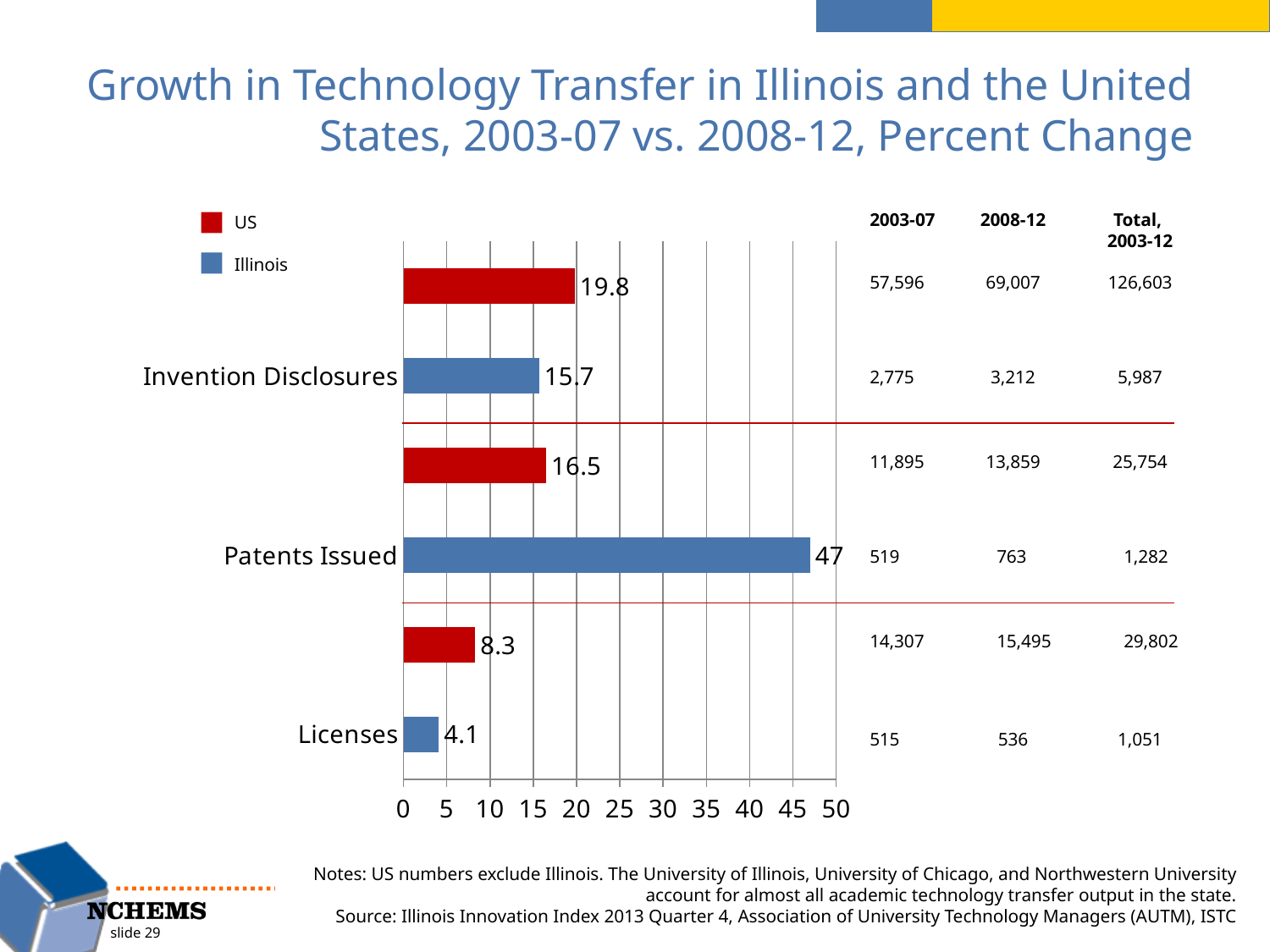
For Invention Disclosures, which is larger: the US or Illinois percent change? US Which category has the lowest percent change for the US? Licenses What is the percent change for Illinois in Licenses? 4.1 Which category has the highest percent change for Illinois? Patents Issued What is the percent change for the US in Invention Disclosures? 19.8 What kind of chart is shown on the slide? Bar chart What is the percent change for Illinois in Patents Issued? 47 How many categories are shown on the chart? 3 Is the Illinois value for Patents Issued greater or less than 45? greater What is the percent change for the US in Licenses? 8.3 What is the difference between the Illinois and US percent change for Patents Issued? 30.5 How many series does the legend list? 2